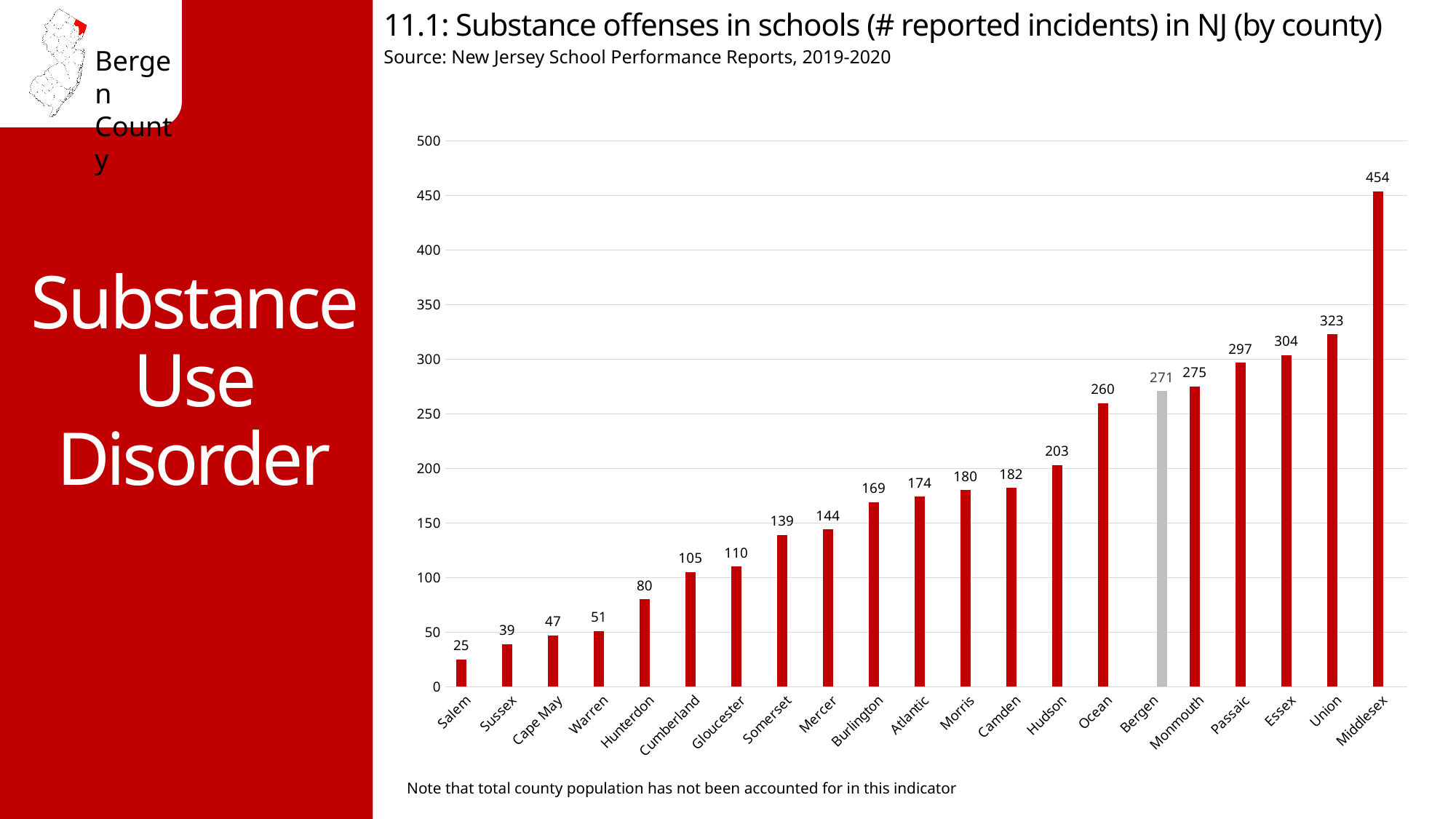
What is the number of reported substance offense incidents in schools for Bergen County? 271 Which county has the highest number of reported incidents? Middlesex What is the value shown for Hudson County? 203 What is the difference between the values for Bergen and Salem? 246 Which county has the lowest number of reported incidents? Salem What kind of chart is shown on the slide? Bar chart Which county has a larger value, Ocean or Monmouth? Monmouth Is the value for Essex greater or less than 300? greater What is the difference between the values for Middlesex and Union? 131 Do the values rise or fall moving from left to right along the x axis? Rise Which county's bar is coloured grey instead of red? Bergen How many counties are shown on the x axis of the chart? 21